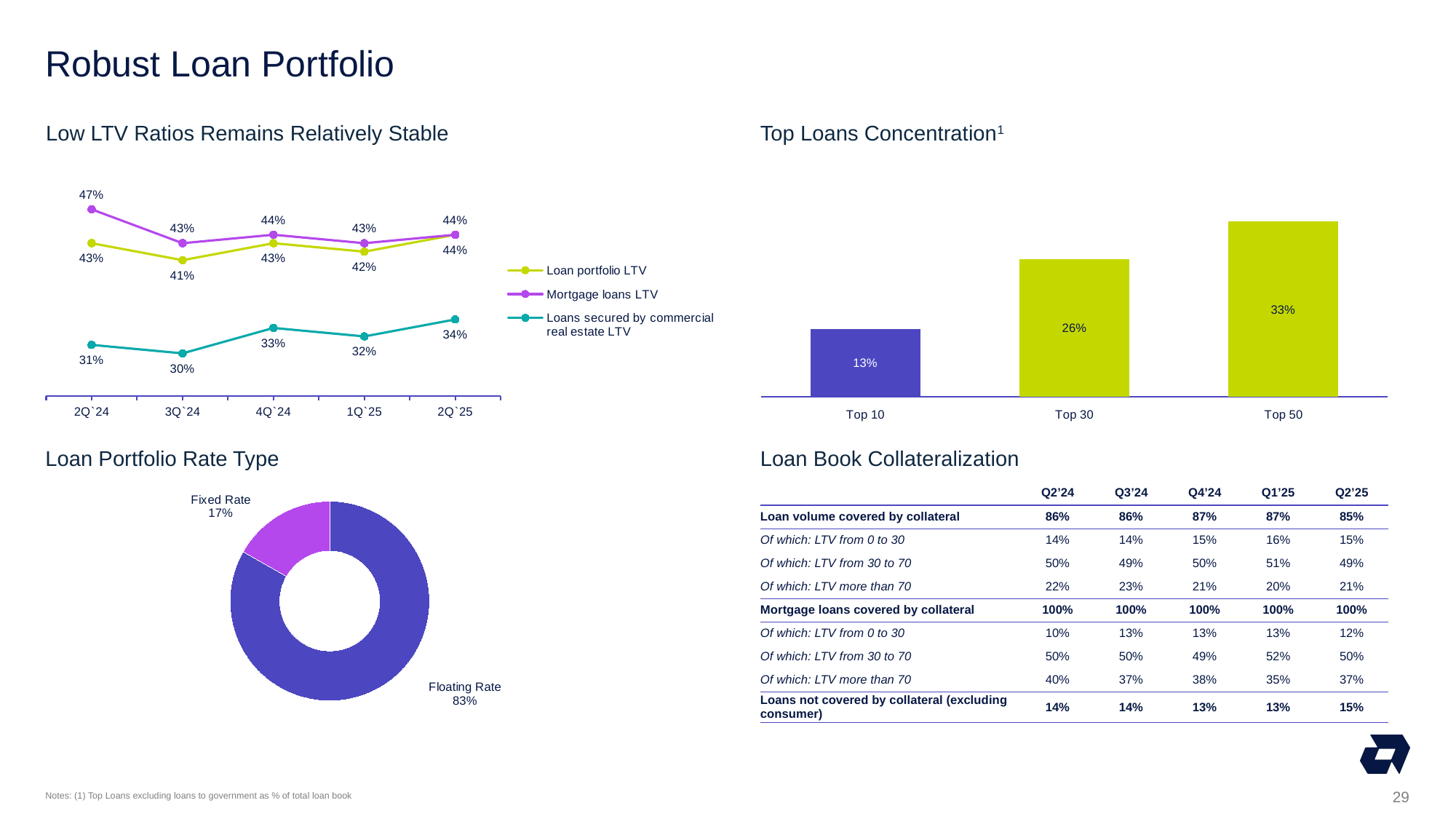
In the Top Loans Concentration chart, what is the difference between the Top 50 and Top 10 values? 20% In the Low LTV Ratios Remains Relatively Stable chart, what is the Loan portfolio LTV value for 1Q`25? 42% In the Top Loans Concentration chart, how many bars are shown? 3 In the Loan Portfolio Rate Type chart, what share is Floating Rate? 83% In the Low LTV Ratios Remains Relatively Stable chart, what is the Loans secured by commercial real estate LTV value for 3Q`24? 30% In the Low LTV Ratios Remains Relatively Stable chart, what kind of chart is used? Line chart In the Top Loans Concentration chart, what is the value for Top 30? 26% In the Low LTV Ratios Remains Relatively Stable chart, what is the Mortgage loans LTV value for 2Q`24? 47% In the Low LTV Ratios Remains Relatively Stable chart, how many series does the legend list? 3 In the Low LTV Ratios Remains Relatively Stable chart, which series has the lowest value at 2Q`25? Loans secured by commercial real estate LTV In the Top Loans Concentration chart, which category has the highest value? Top 50 In the Loan Portfolio Rate Type chart, which slice is larger, Fixed Rate or Floating Rate? Floating Rate